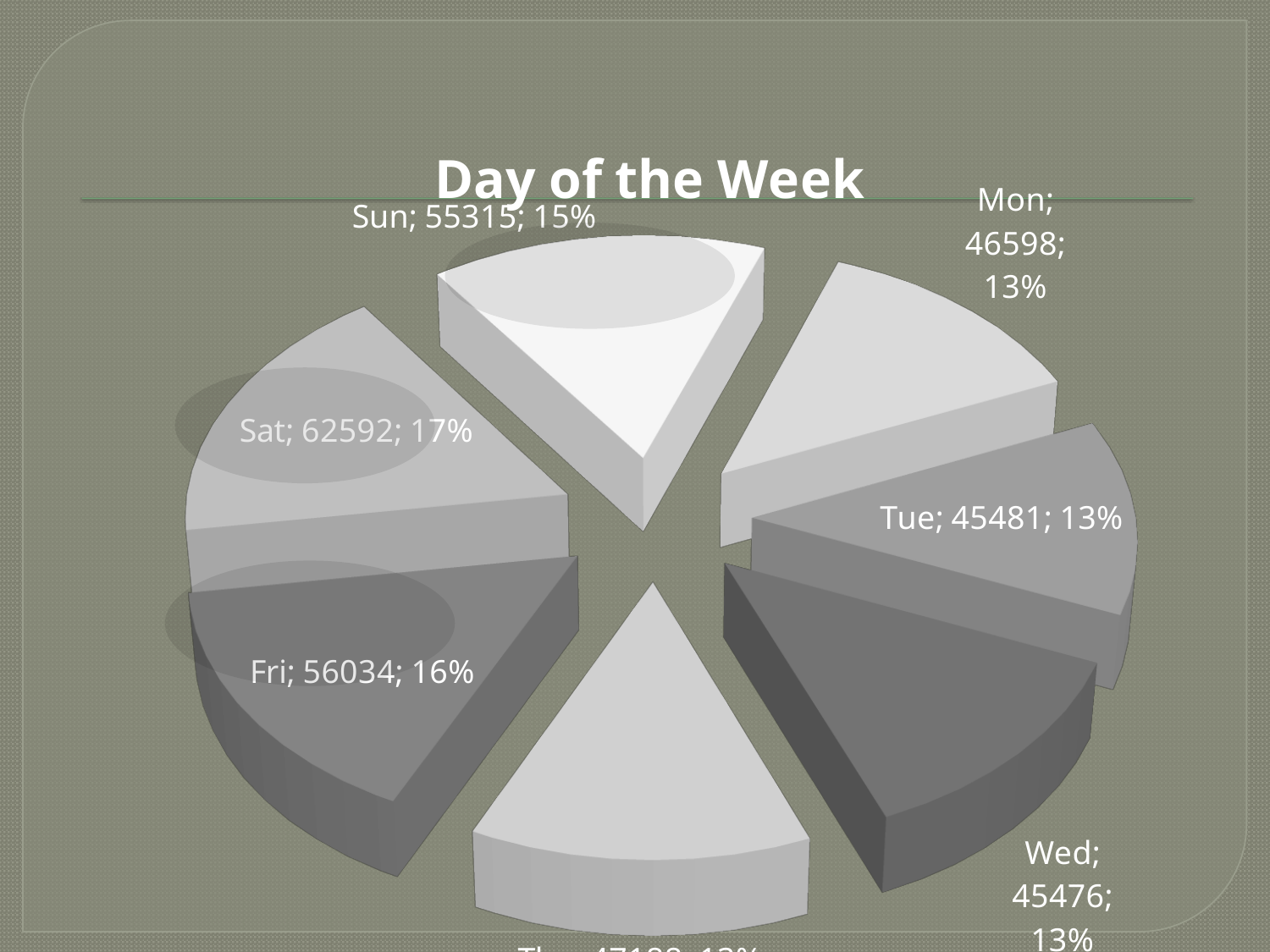
What share of the pie does Sun represent? 15% What type of chart is shown on the slide? pie chart Which day has the largest slice of the pie? Sat What is the value for Sat? 62592 What is the value for Mon? 46598 How many slices does the pie chart have? 7 What is the value for Fri? 56034 What is the title of the chart? Day of the Week What share of the pie does Sat represent? 17% What is the difference between the values for Sat and Fri? 6558 Which is larger, the value for Mon or the value for Tue? Mon What is the value for Tue? 45481